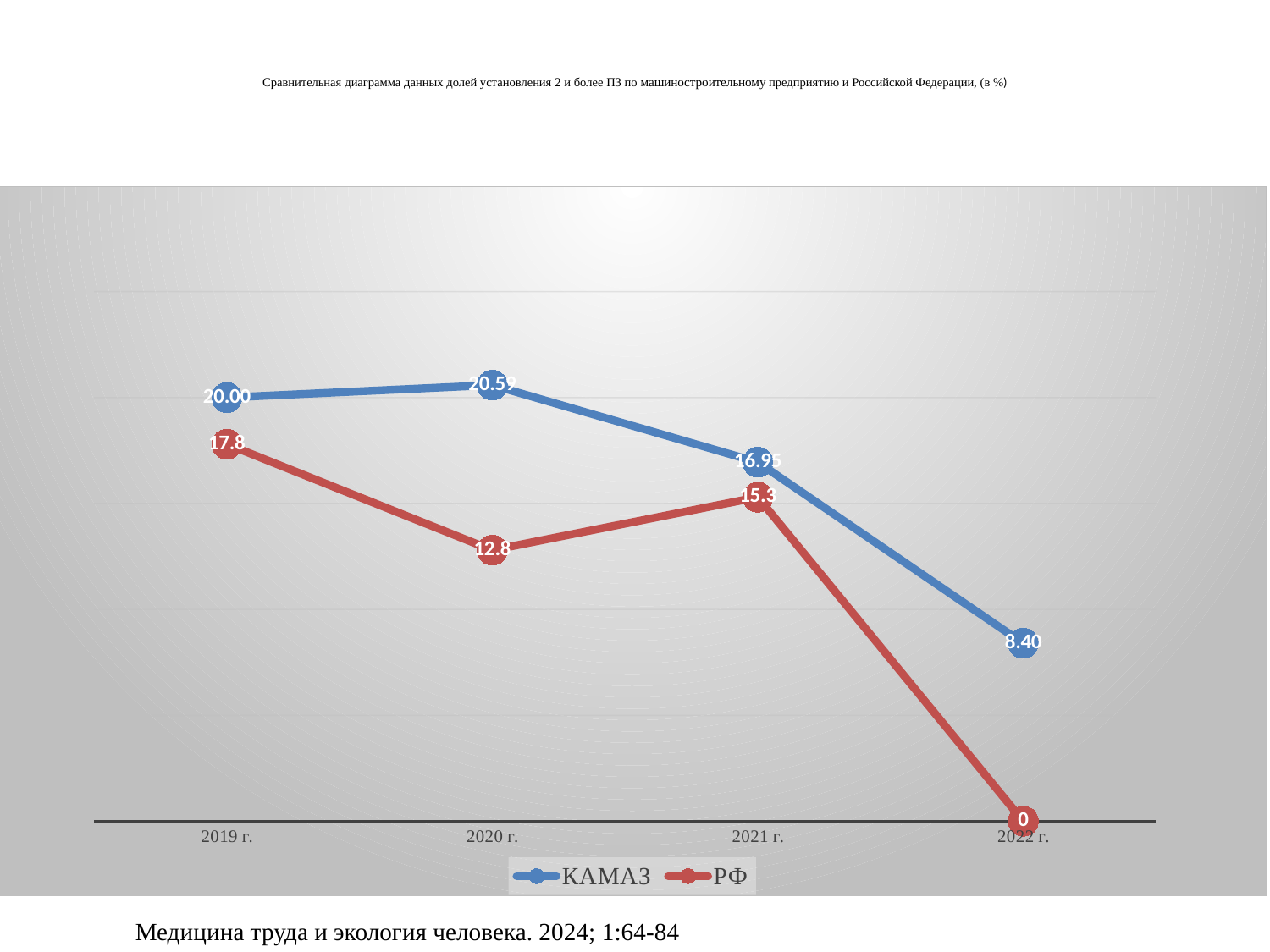
Does the КАМАЗ series rise or fall from 2020 г. to 2022 г.? Fall What is the difference between the КАМАЗ and РФ values in 2020 г.? 7.79 What is the value for РФ in 2021 г.? 15.3 In which year is the РФ series lowest? 2022 г. What is the value for КАМАЗ in 2020 г.? 20.59 How many years are shown on the x axis? 4 Which series has the larger value in 2021 г., КАМАЗ or РФ? КАМАЗ In which year is the КАМАЗ series highest? 2020 г. What is the value for КАМАЗ in 2022 г.? 8.40 What type of chart is shown on the slide? Line chart How many series does the legend list? 2 What is the value for РФ in 2019 г.? 17.8